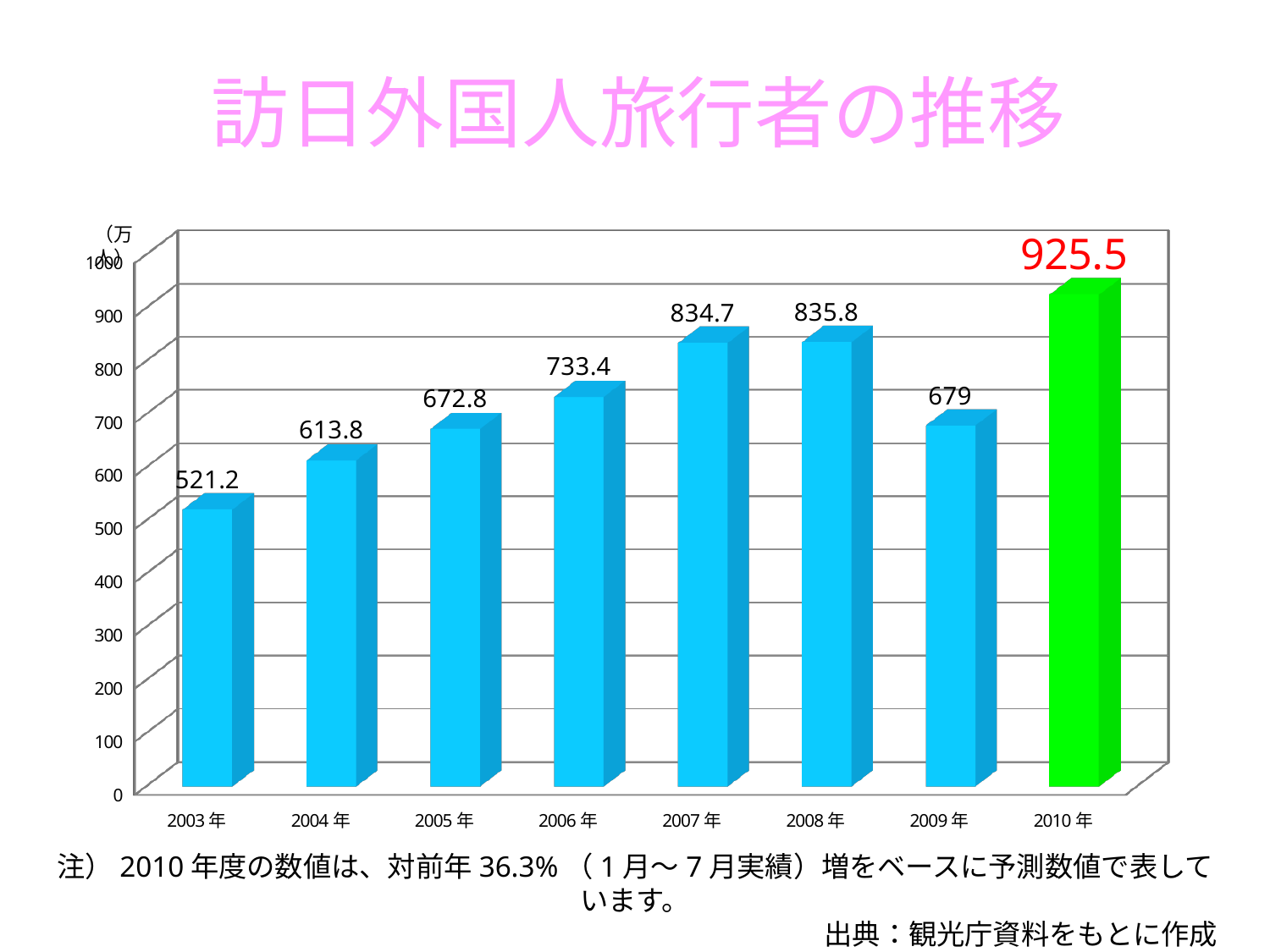
What is the value for 2010年? 925.5 Which is larger, the value for 2006年 or the value for 2009年? 2006年 Which year has the lowest value? 2003年 What is the value for 2009年? 679 What is the difference between the values for 2008年 and 2007年? 1.1 Do the values rise or fall from 2003年 to 2008年? rise What colour is the bar for 2010年? green What is the value for 2003年? 521.2 What kind of chart is shown on the slide? bar chart How many years are shown on the x axis? 8 Which year has the highest value? 2010年 What is the difference between the values for 2010年 and 2009年? 246.5